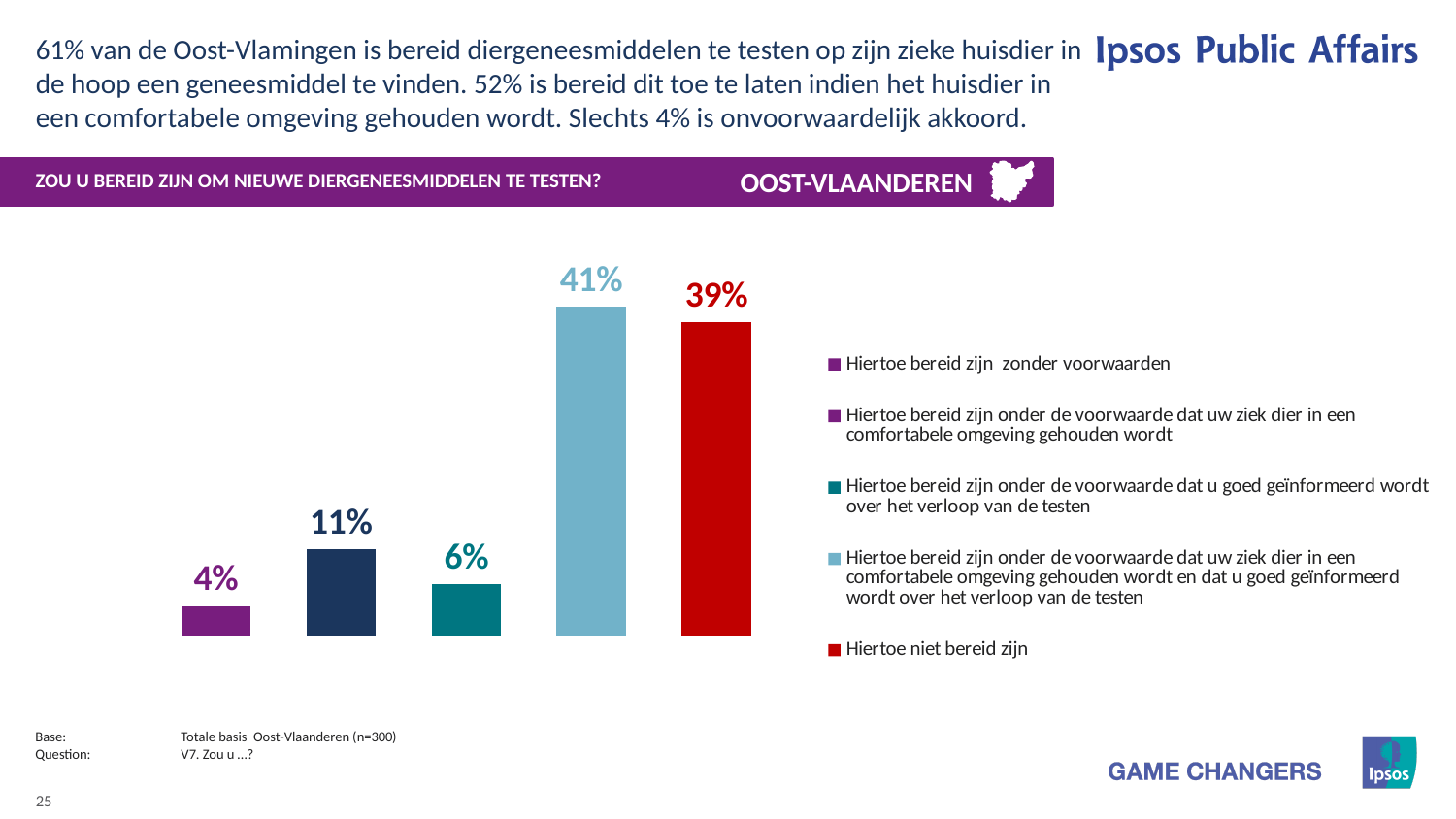
What is the value for 'Hiertoe niet bereid zijn'? 39% What is the value for 'Hiertoe bereid zijn onder de voorwaarde dat uw ziek dier in een comfortabele omgeving gehouden wordt'? 11% What is the value for 'Hiertoe bereid zijn onder de voorwaarde dat u goed geïnformeerd wordt over het verloop van de testen'? 6% What is the difference between the highest bar (41%) and the 'Hiertoe niet bereid zijn' bar? 2% Which category has the lowest value in the chart? Hiertoe bereid zijn zonder voorwaarden Which region is named in the header bar above the chart? OOST-VLAANDEREN How many entries does the chart legend list? 5 Which is larger: the value for 'Hiertoe bereid zijn onder de voorwaarde dat uw ziek dier in een comfortabele omgeving gehouden wordt' or the value for 'Hiertoe bereid zijn onder de voorwaarde dat u goed geïnformeerd wordt over het verloop van de testen'? Hiertoe bereid zijn onder de voorwaarde dat uw ziek dier in een comfortabele omgeving gehouden wordt What type of chart is shown on the slide? bar chart Which category has the highest value in the chart? Hiertoe bereid zijn onder de voorwaarde dat uw ziek dier in een comfortabele omgeving gehouden wordt en dat u goed geïnformeerd wordt over het verloop van de testen What is the value for 'Hiertoe bereid zijn zonder voorwaarden'? 4% How many bars are plotted in the chart? 5